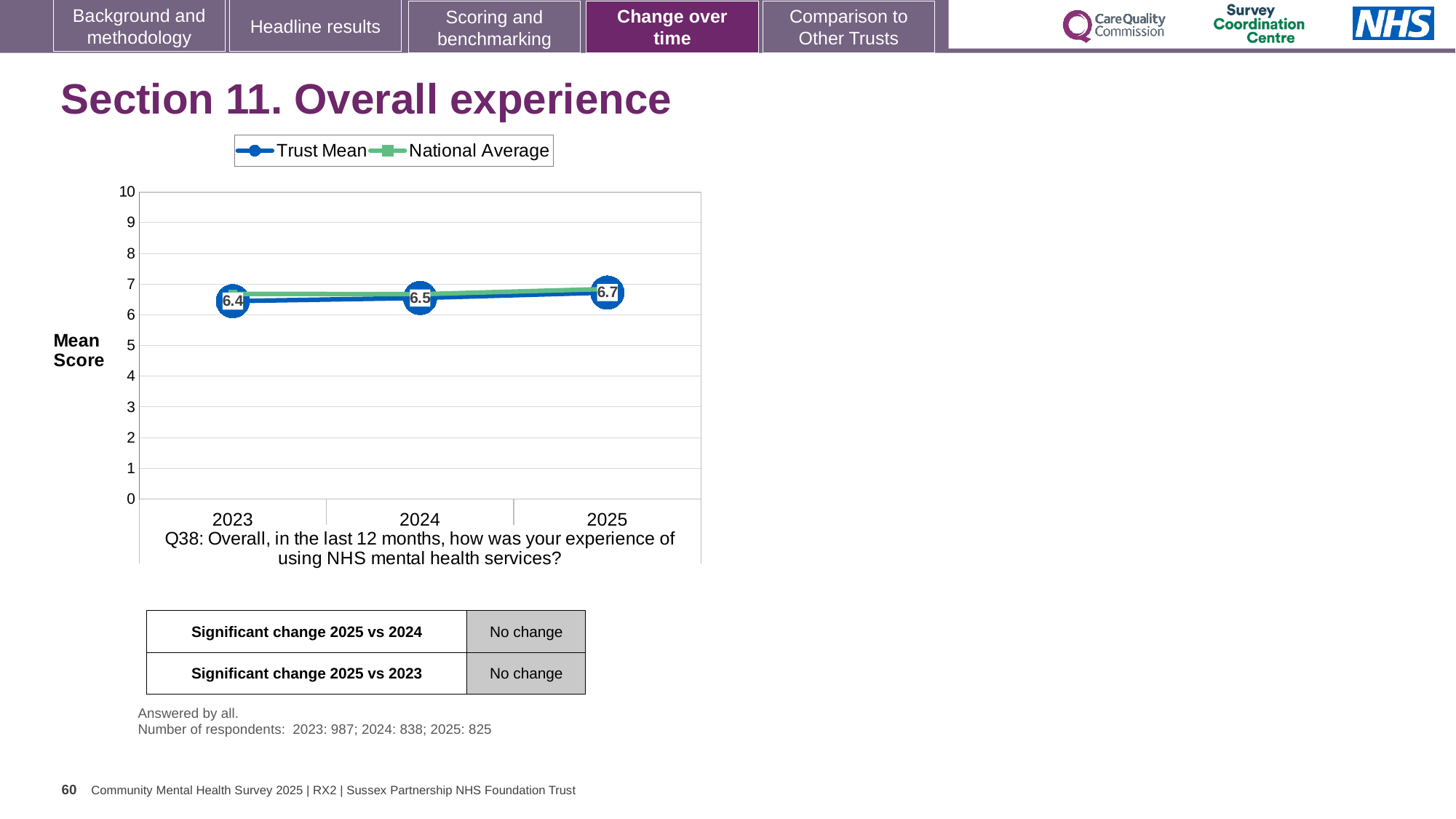
What is the Trust Mean score for 2023? 6.4 Is the National Average value for 2025 greater or less than 8? less In which year is the Trust Mean score lowest? 2023 What is the Trust Mean score for 2024? 6.5 What is the Trust Mean score for 2025? 6.7 In which year is the Trust Mean score highest? 2025 How many series does the legend list? 2 What is the difference between the Trust Mean score in 2025 and in 2023? 0.3 What kind of chart is shown on the slide? Line chart Which is larger, the Trust Mean score for 2025 or for 2024? 2025 Is the National Average value for 2023 greater or less than 5? greater How many years are plotted on the x axis? 3